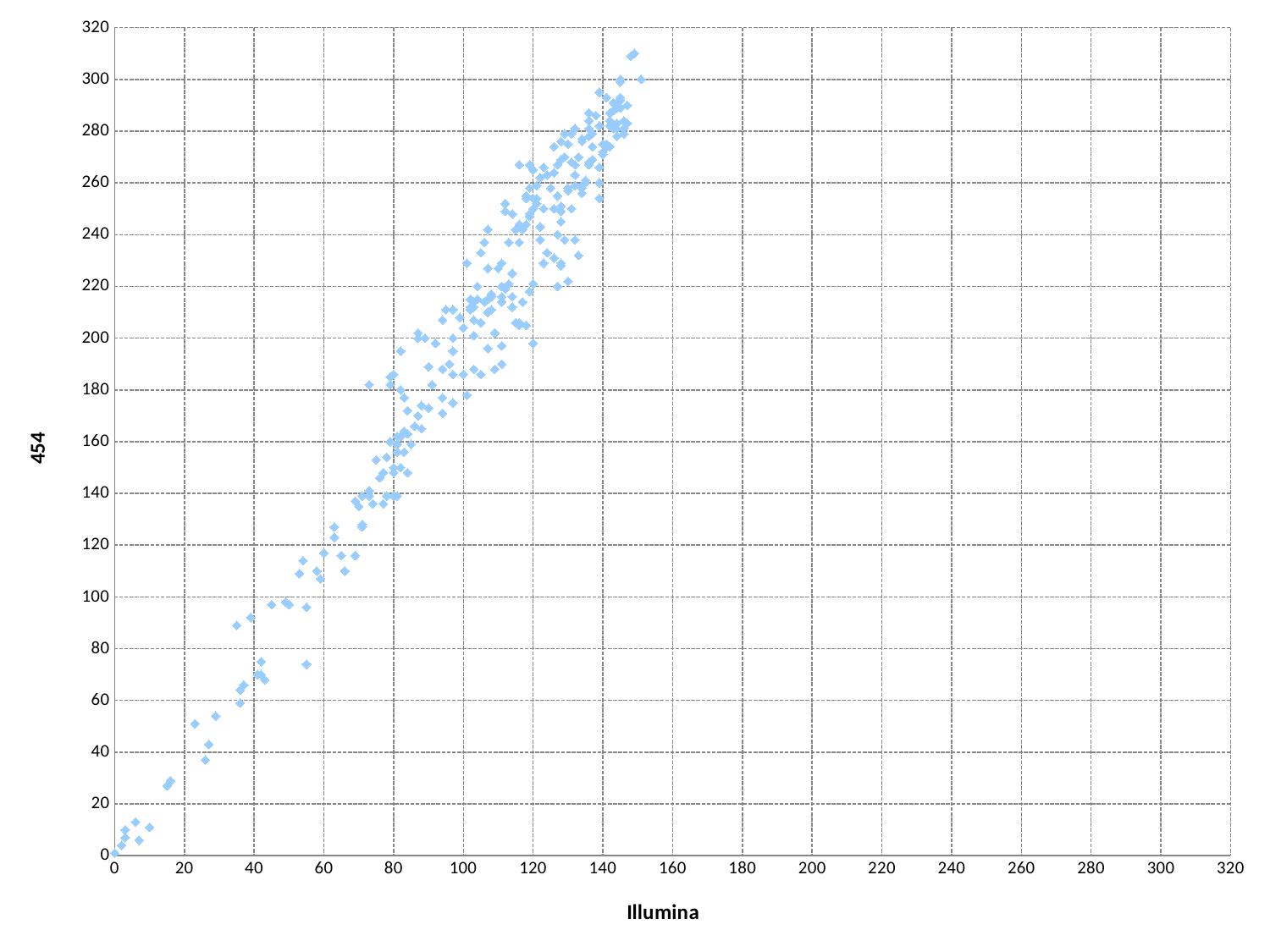
Are any points plotted with an Illumina value greater than 200? no What is the label of the x axis? Illumina Do the 454 values generally rise or fall as the Illumina values increase along the x axis? rise What kind of chart is shown on the slide? scatter plot Is the largest Illumina value plotted greater or less than 140? greater What is the maximum value shown on the x axis? 320 What is the label of the y axis? 454 Is the largest Illumina value plotted greater or less than 160? less